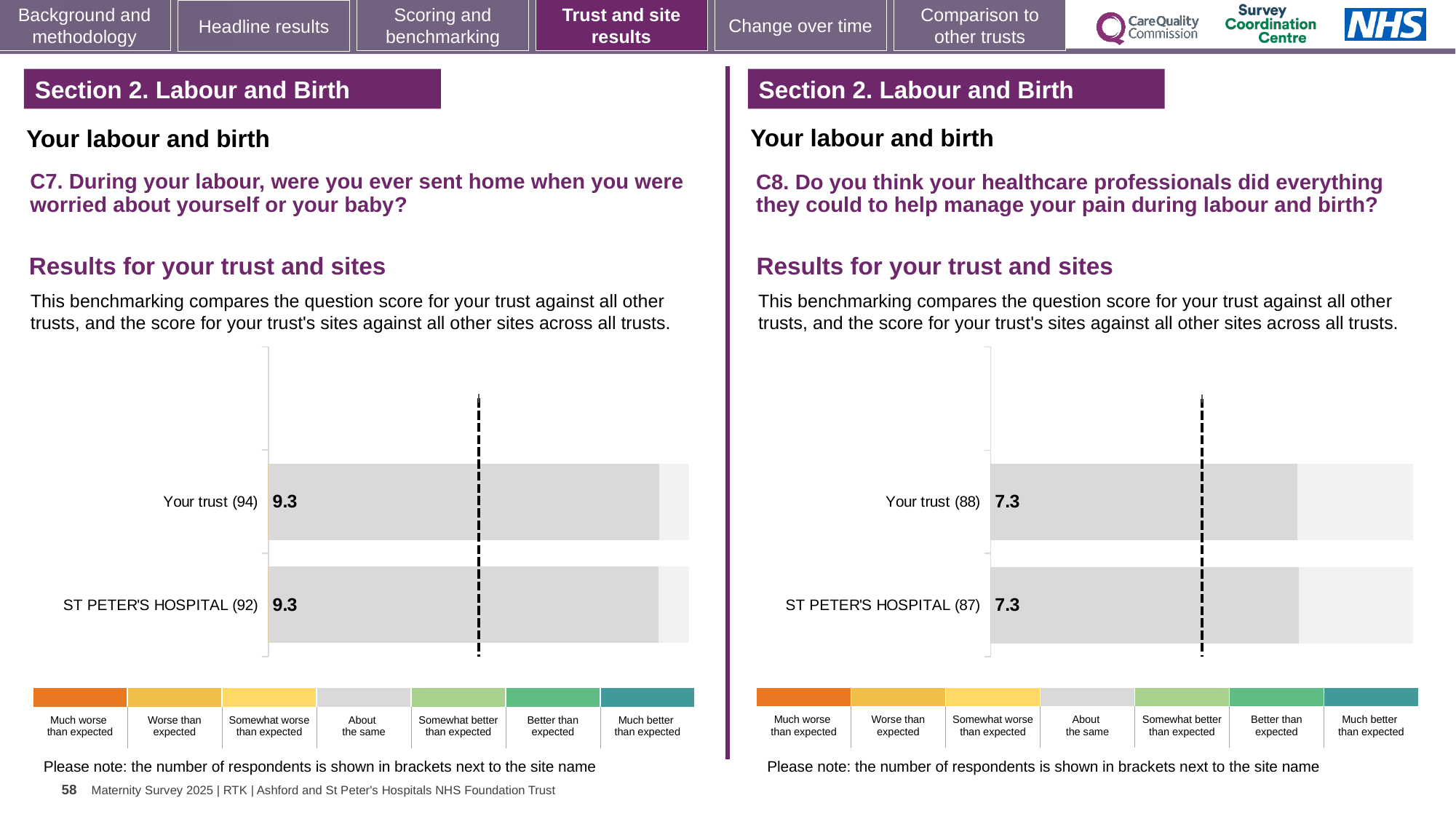
What kind of chart is used in the C7 chart on the left? Bar chart In the C7 chart on the left, what is the difference between the Your trust score and the ST PETER'S HOSPITAL score? 0 How many bars are plotted in the C7 chart on the left? 2 In the C8 chart on the right, what is the score for ST PETER'S HOSPITAL? 7.3 In the C8 chart on the right, how many respondents are shown in brackets for ST PETER'S HOSPITAL? 87 In the C8 chart on the right, what is the score for Your trust? 7.3 How many bars are plotted in the C8 chart on the right? 2 In the C7 chart on the left, how many respondents are shown in brackets for Your trust? 94 Is the Your trust score in the C7 chart on the left larger or smaller than the Your trust score in the C8 chart on the right? Larger In the C8 chart on the right, what is the difference between the Your trust score and the ST PETER'S HOSPITAL score? 0 In the C7 chart on the left, what is the score for ST PETER'S HOSPITAL? 9.3 In the C7 chart on the left, what is the score for Your trust? 9.3